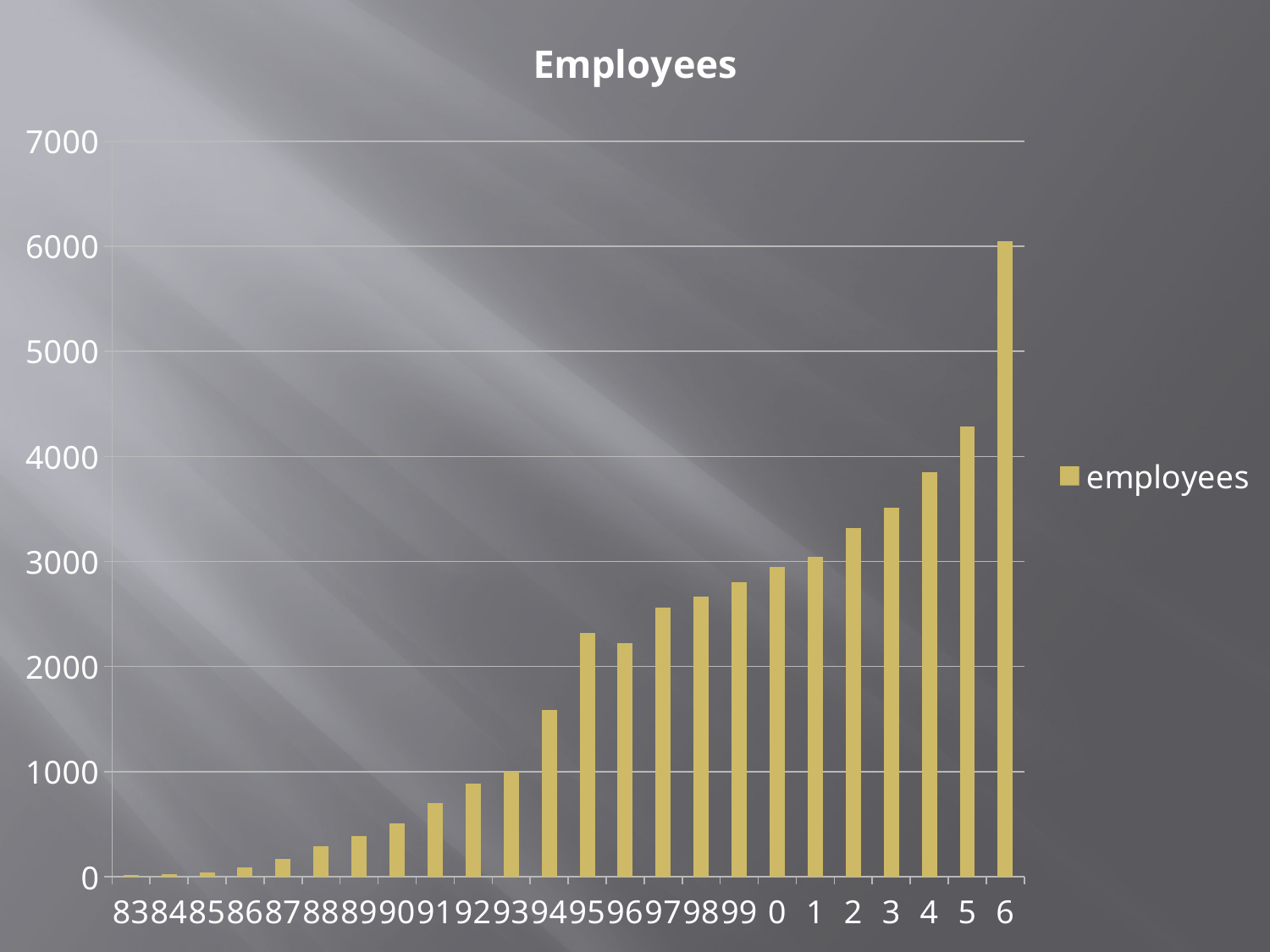
How many series does the legend list? 1 Which is larger, the value for 95 or the value for 96? 95 Is the value for 2 greater or less than 3000? greater How many categories are plotted along the x axis? 24 Is the value for 5 greater or less than 4000? greater Do the values generally rise or fall from left to right along the x axis? rise What kind of chart is shown on the slide? bar chart What is the title of the chart? Employees Which category has the highest number of employees? 6 Is the value for 90 greater or less than 1000? less